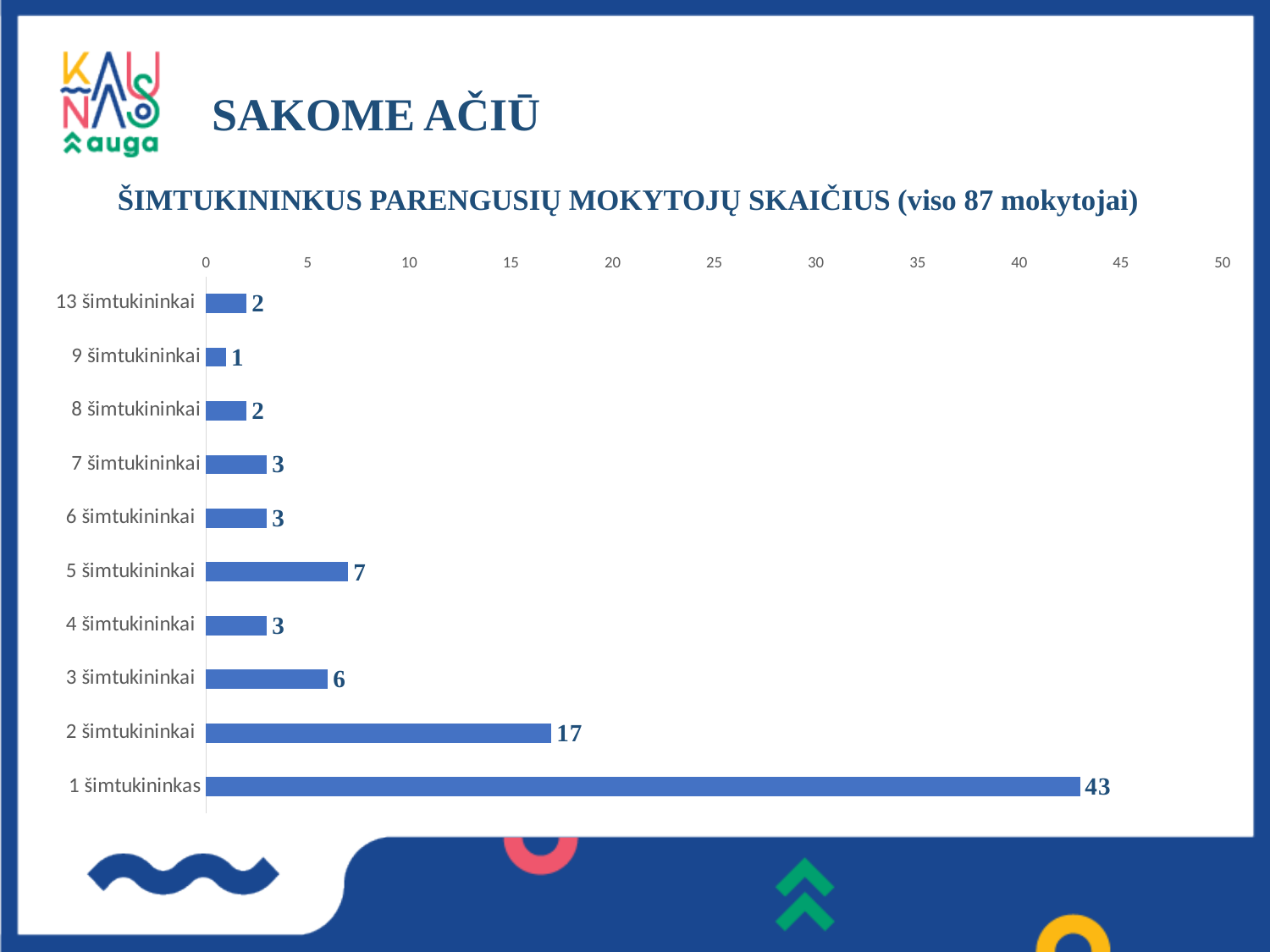
What is the value for "5 šimtukininkai"? 7 What is the title of the chart? ŠIMTUKININKUS PARENGUSIŲ MOKYTOJŲ SKAIČIUS (viso 87 mokytojai) How many categories are shown in the chart? 10 Which category has the lowest value? 9 šimtukininkai Which is larger, the value for "3 šimtukininkai" or the value for "5 šimtukininkai"? 5 šimtukininkai What kind of chart is shown on the slide? bar chart What is the value for "2 šimtukininkai"? 17 What is the value for "1 šimtukininkas"? 43 Is the value for "1 šimtukininkas" greater or less than 40? greater What is the difference between the values for "1 šimtukininkas" and "2 šimtukininkai"? 26 What is the value for "9 šimtukininkai"? 1 Which category has the highest value? 1 šimtukininkas